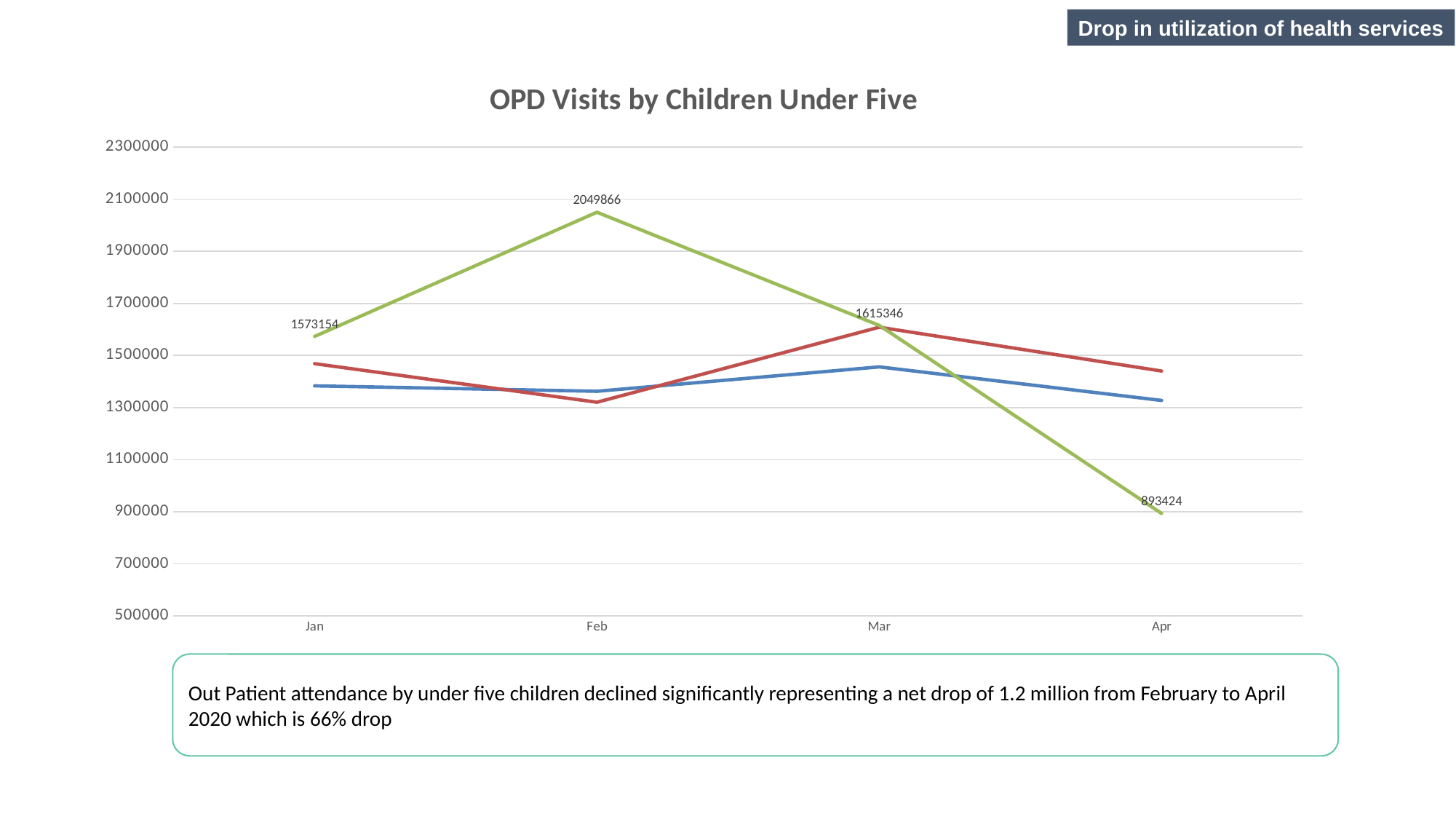
How many months are shown on the x axis? 4 In which month does the green line reach its highest value? Feb Is the value of the red line in Feb greater or less than 1500000? less What is the value of the green line in Feb? 2049866 Does the green line rise or fall from Feb to Apr? fall What is the value of the green line in Apr? 893424 What is the difference between the green line's Feb value and its Apr value? 1156442 What type of chart is shown on the slide? line chart In which month does the green line reach its lowest value? Apr How many lines are plotted on the chart? 3 What is the title of the chart? OPD Visits by Children Under Five What is the value of the green line in Jan? 1573154